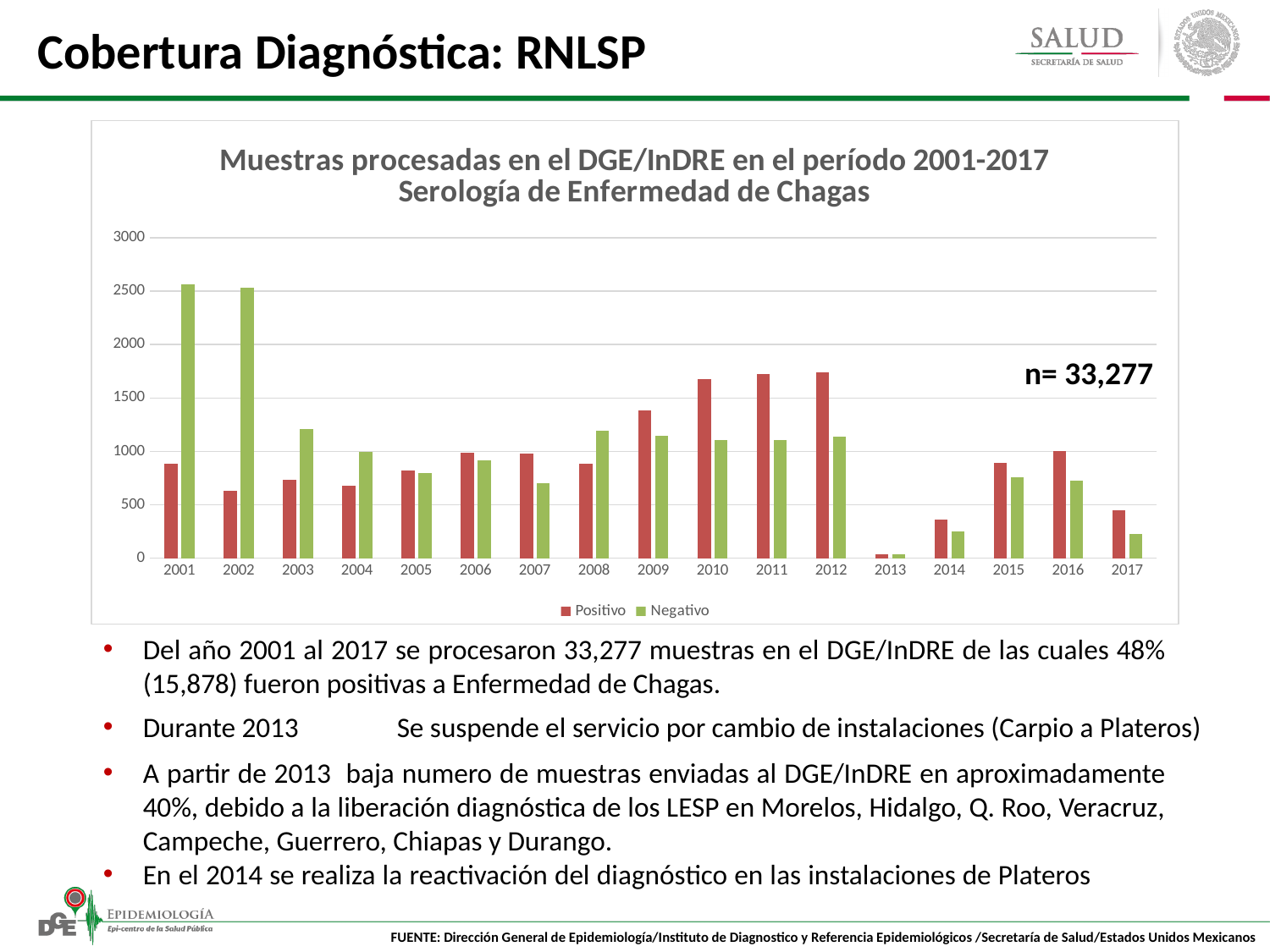
Is the Positivo value for 2014 greater or less than 500? less In which year is the Negativo value lowest? 2013 Is the Negativo value for 2003 greater or less than 1000? greater What kind of chart is shown on the slide? bar chart Is the Negativo value for 2001 greater or less than 2000? greater How many years are shown along the x axis of the chart? 17 What sample size (n) is printed on the chart? n= 33,277 In 2010, which is larger, the Positivo value or the Negativo value? Positivo How many series does the chart legend list? 2 In 2001, which is larger, the Positivo value or the Negativo value? Negativo In which year is the Positivo value lowest? 2013